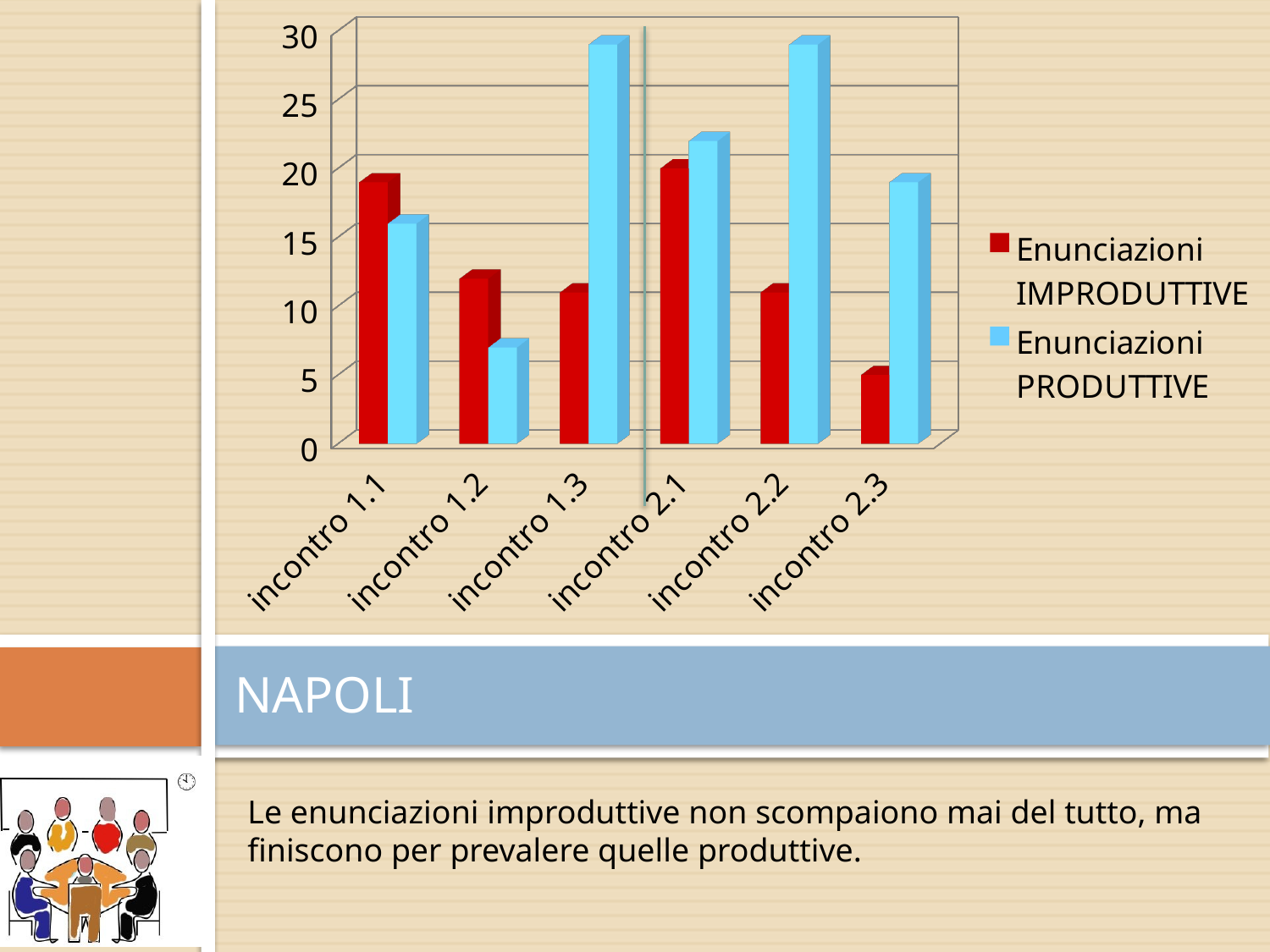
Which colour represents Enunciazioni IMPRODUTTIVE in the chart? red Is the value for Enunciazioni IMPRODUTTIVE at incontro 2.3 greater or less than 10? less How many series does the legend list? 2 Which category has the lowest value for Enunciazioni PRODUTTIVE? incontro 1.2 Is the value for Enunciazioni PRODUTTIVE at incontro 1.3 greater or less than 25? greater How many categories (incontri) are shown on the x axis? 6 Which category has the lowest value for Enunciazioni IMPRODUTTIVE? incontro 2.3 At incontro 1.2, which is larger: Enunciazioni IMPRODUTTIVE or Enunciazioni PRODUTTIVE? Enunciazioni IMPRODUTTIVE At incontro 1.3, which is larger: Enunciazioni IMPRODUTTIVE or Enunciazioni PRODUTTIVE? Enunciazioni PRODUTTIVE What kind of chart is shown on the slide? bar chart Is the value for Enunciazioni PRODUTTIVE at incontro 1.2 greater or less than 10? less At incontro 2.3, which is larger: Enunciazioni IMPRODUTTIVE or Enunciazioni PRODUTTIVE? Enunciazioni PRODUTTIVE